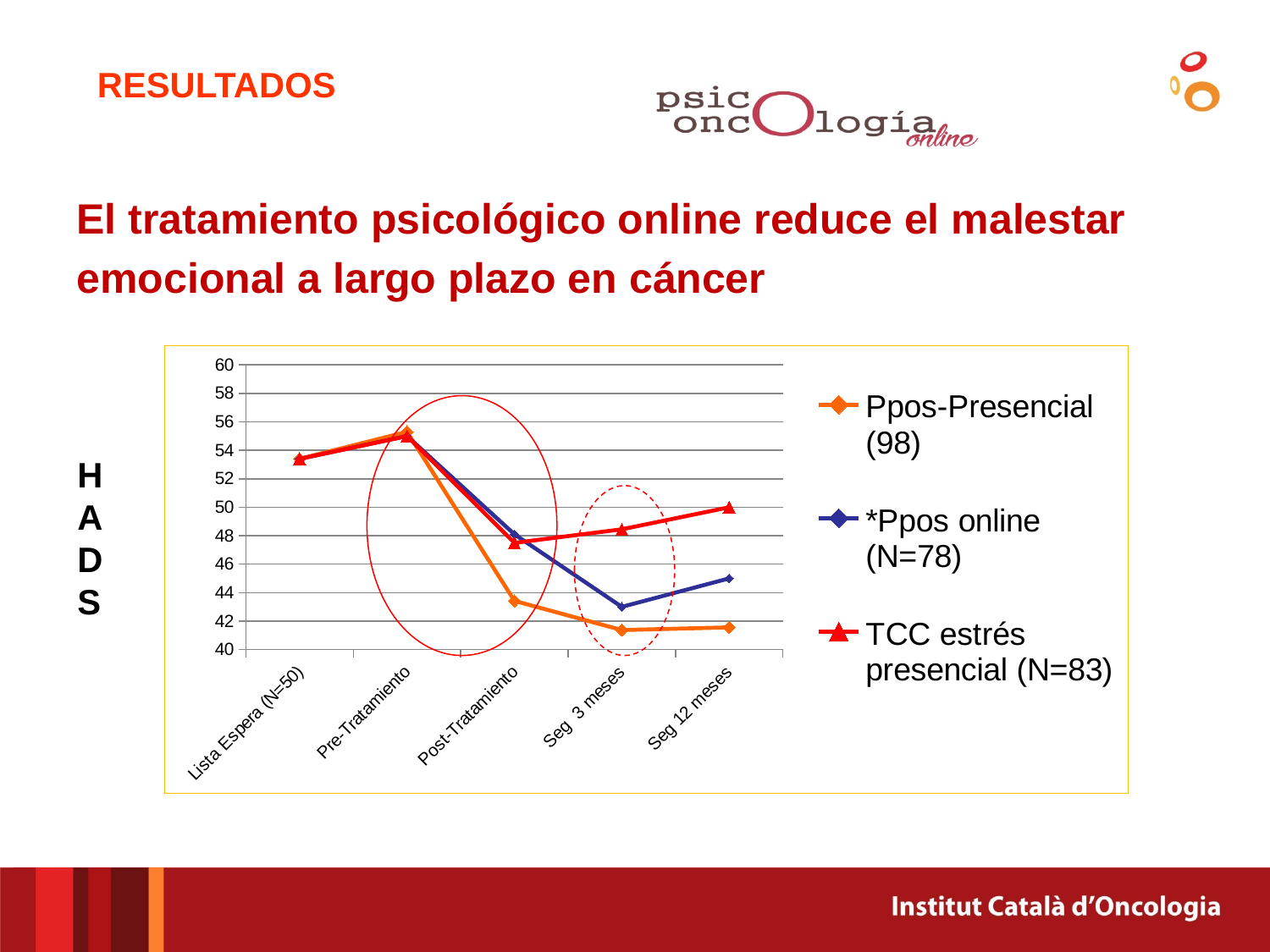
Does the value for Ppos-Presencial (98) rise or fall from Pre-Tratamiento to Seg 3 meses? fall How many series does the chart legend list? 3 What kind of chart is shown on the slide? line chart What label is shown on the vertical axis of the chart? HADS How many categories are shown along the x axis of the chart? 5 Which series has the highest value at Seg 12 meses? TCC estrés presencial (N=83) Is the value for TCC estrés presencial (N=83) at Seg 3 meses greater or less than 46? greater Is the value for Ppos-Presencial (98) at Post-Tratamiento greater or less than 46? less Which series has the lowest value at Seg 3 meses? Ppos-Presencial (98) At Seg 12 meses, which is larger: the value for TCC estrés presencial (N=83) or the value for Ppos-Presencial (98)? TCC estrés presencial (N=83) Is the value for *Ppos online (N=78) at Seg 12 meses greater or less than 48? less